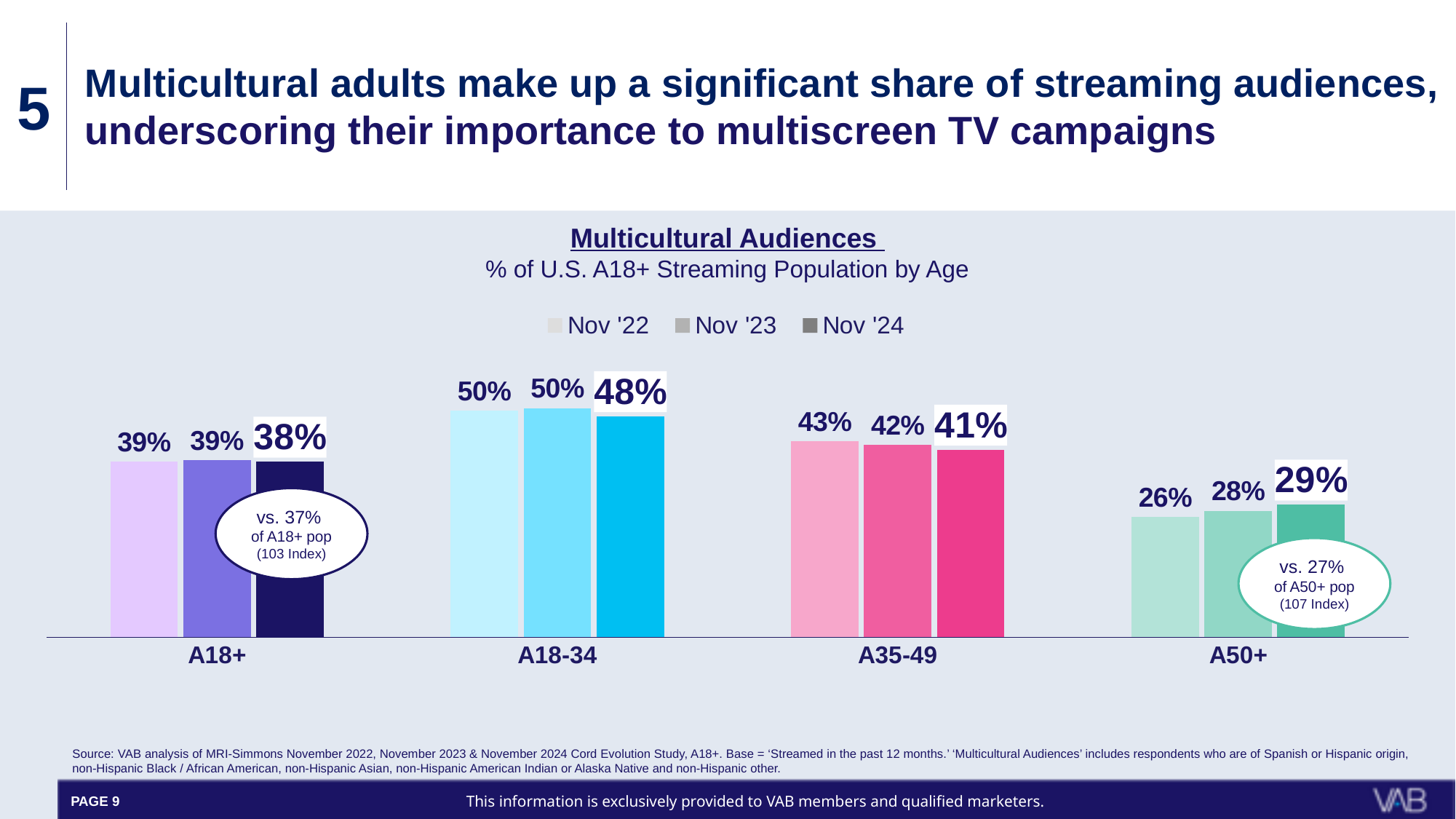
How many series does the legend list? 3 What kind of chart is shown? Bar chart Which age group has the highest Nov '24 value? A18-34 How many age groups are shown on the x axis? 4 Do the values for A50+ rise or fall from Nov '22 to Nov '24? Rise What is the Nov '24 value for A18-34? 48% What is the subtitle of the chart below 'Multicultural Audiences'? % of U.S. A18+ Streaming Population by Age Which age group has the lowest Nov '22 value? A50+ What is the Nov '22 value for A50+? 26% What is the difference between the Nov '22 and Nov '24 values for A35-49? 2% What is the Nov '23 value for A35-49? 42% Which is larger for A50+: the Nov '22 value or the Nov '24 value? Nov '24